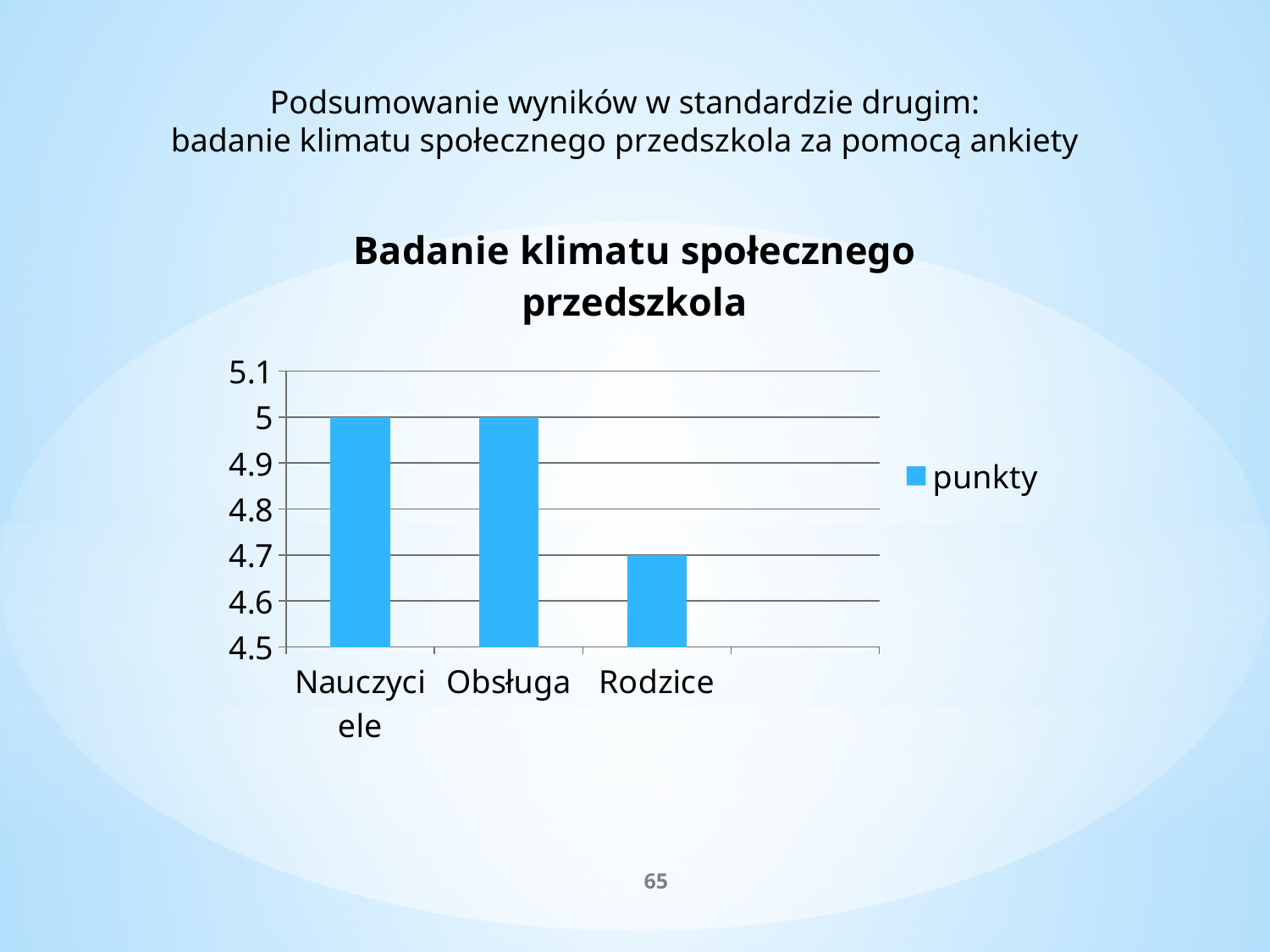
What is the value for Obsługa? 5 What is the name of the series shown in the legend? punkty What is the title of the chart? Badanie klimatu społecznego przedszkola Which is larger, the value for Obsługa or the value for Rodzice? Obsługa Is the value for Rodzice greater or less than 4.9? less What type of chart is shown on the slide? bar chart What is the value for Rodzice? 4.7 What is the difference between the value for Nauczyciele and the value for Rodzice? 0.3 Which category has the lowest value? Rodzice How many categories are shown on the x axis of the chart? 3 What is the value for Nauczyciele? 5 How many series does the legend list? 1